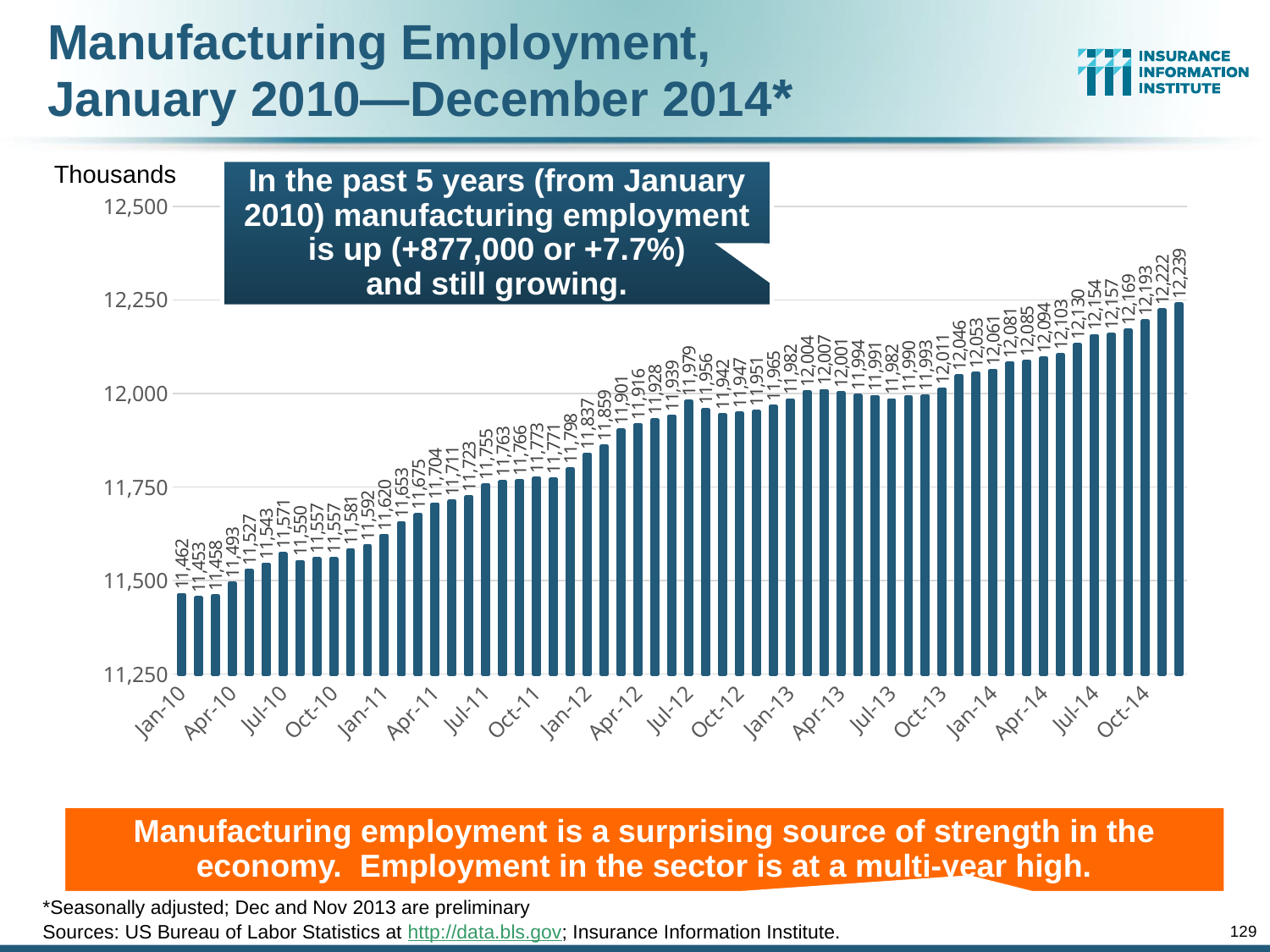
What is the manufacturing employment value for Jan-10? 11,462 What unit label is shown above the y axis of the chart? Thousands What kind of chart is shown on the slide? bar chart By how much does the value for Jan-14 exceed the value for Jan-10? 599 What is the manufacturing employment value for Jan-14? 12,061 What is the highest value shown in the chart? 12,239 Do the values generally rise or fall from Jan-10 to Dec-14? rise Which is larger, the value for Apr-11 or the value for Apr-12? Apr-12 What is the lowest value shown in the chart? 11,453 Is the value for Jan-12 greater or less than 12,000? less What is the value of the last bar (December 2014) in the chart? 12,239 What is the manufacturing employment value for Oct-13? 12,011